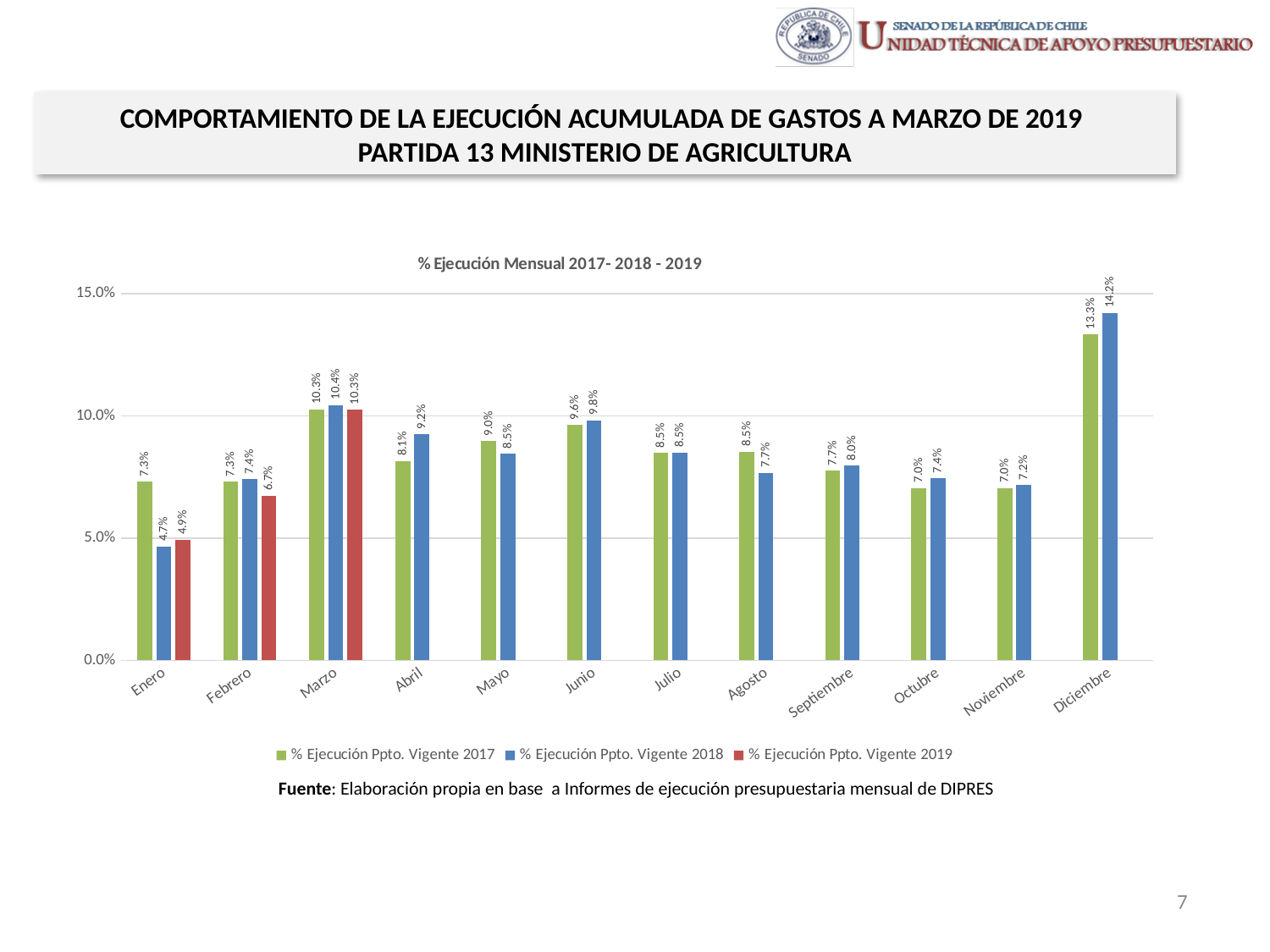
In which month is the % Ejecución Ppto. Vigente 2017 value highest? Diciembre What is the value for % Ejecución Ppto. Vigente 2018 in Diciembre? 14.2% For how many months does the 2019 series have a bar? 3 How many series does the legend list? 3 What is the value for % Ejecución Ppto. Vigente 2019 in Marzo? 10.3% What kind of chart is shown on the slide? Bar chart What is the title of the chart? % Ejecución Mensual 2017- 2018 - 2019 Which is larger in Enero: the 2017 value or the 2018 value? 2017 value (7.3%) What is the value for % Ejecución Ppto. Vigente 2017 in Abril? 8.1% In which month is the % Ejecución Ppto. Vigente 2018 value lowest? Enero What is the difference between the 2018 and 2017 values in Diciembre? 0.9% How many months are shown on the x axis? 12